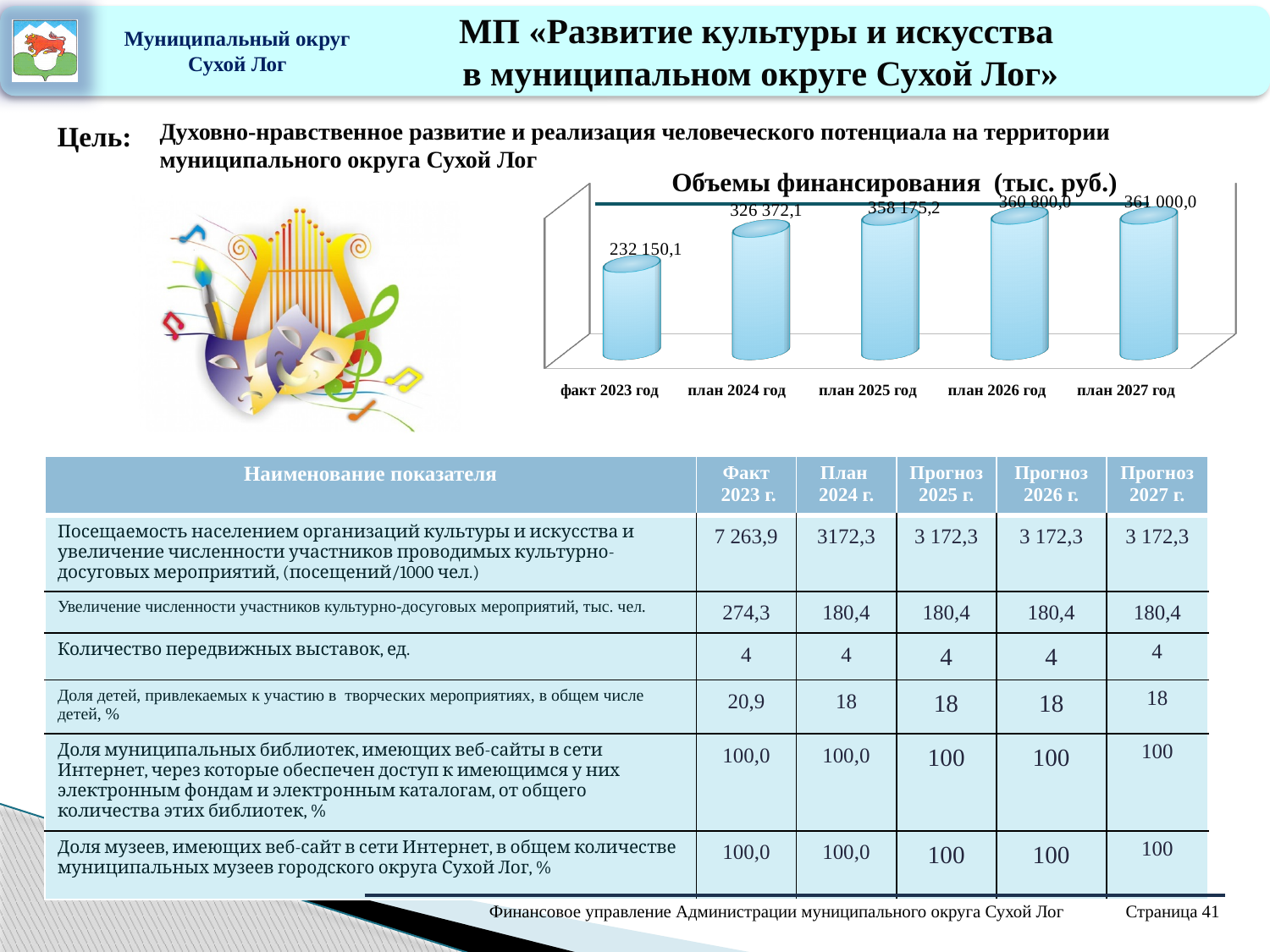
In the chart 'Объемы финансирования (тыс. руб.)', which is larger: the value for план 2025 год or the value for план 2024 год? план 2025 год In the chart 'Объемы финансирования (тыс. руб.)', what is the difference between the values for план 2027 год and план 2026 год? 200,0 What kind of chart is 'Объемы финансирования (тыс. руб.)'? bar chart Which category has the lowest value in the chart 'Объемы финансирования (тыс. руб.)'? факт 2023 год What is the value for план 2024 год in the chart 'Объемы финансирования (тыс. руб.)'? 326 372,1 What is the value for факт 2023 год in the chart 'Объемы финансирования (тыс. руб.)'? 232 150,1 What is the value for план 2025 год in the chart 'Объемы финансирования (тыс. руб.)'? 358 175,2 What is the value for план 2026 год in the chart 'Объемы финансирования (тыс. руб.)'? 360 800,0 In the chart 'Объемы финансирования (тыс. руб.)', what is the difference between the values for план 2024 год and факт 2023 год? 94 222,0 What is the value for план 2027 год in the chart 'Объемы финансирования (тыс. руб.)'? 361 000,0 Which category has the highest value in the chart 'Объемы финансирования (тыс. руб.)'? план 2027 год How many categories are shown in the chart 'Объемы финансирования (тыс. руб.)'? 5